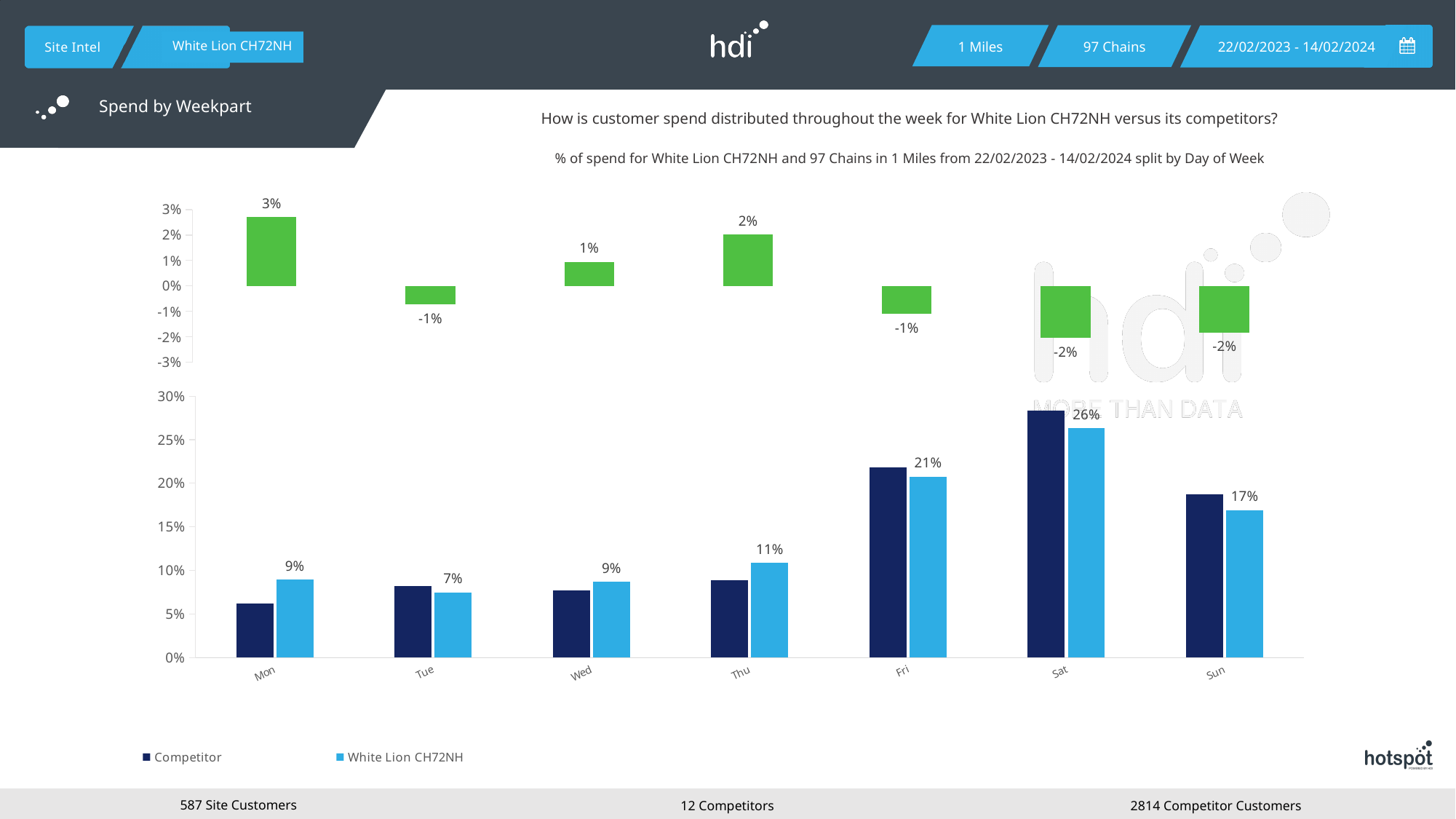
In the bottom chart, which day has the highest White Lion CH72NH value? Sat In the bottom chart, is the Competitor value for Mon greater or less than 10%? less In the bottom chart, what is the value for White Lion CH72NH on Sat? 26% In the bottom chart, is the Competitor value for Sat greater or less than 25%? greater In the bottom chart, what is the difference between the White Lion CH72NH values for Sat and Sun? 9% In the bottom chart, what is the value for White Lion CH72NH on Thu? 11% In the top chart, which day has the highest value? Mon In the top chart, what is the value for Mon? 3% How many days are shown on the x axis of the bottom chart? 7 In the bottom chart, which is larger on Fri: the Competitor bar or the White Lion CH72NH bar? Competitor In the bottom chart, which day has the lowest White Lion CH72NH value? Tue How many series does the legend of the bottom chart list? 2